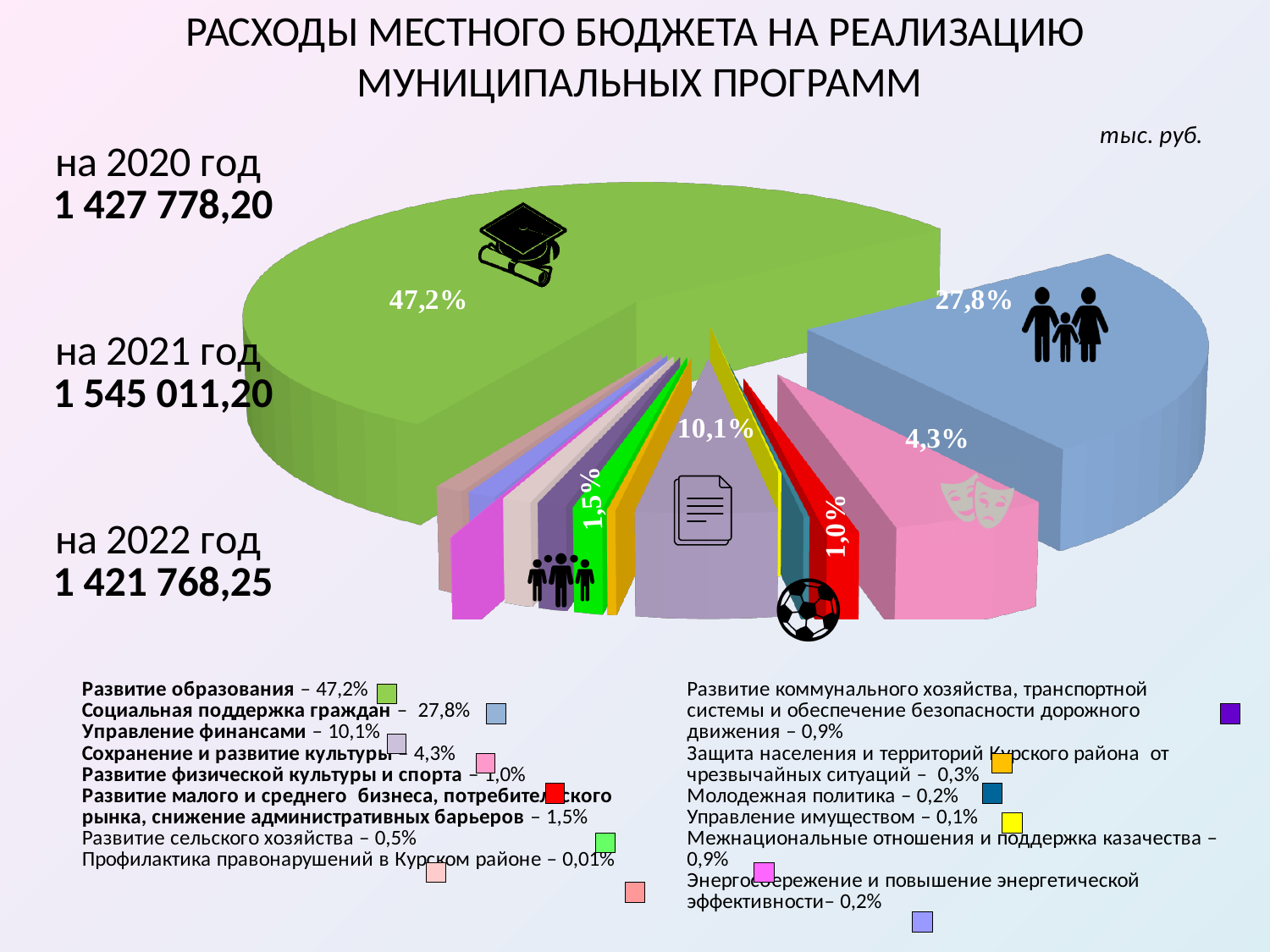
Which is larger: the share for "Управление финансами" or for "Сохранение и развитие культуры"? Управление финансами What percentage is given for "Сохранение и развитие культуры"? 4,3% What is the value for "Развитие физической культуры и спорта"? 1,0% How many categories does the legend list? 14 What is the value for "Управление финансами"? 10,1% What is the total local budget expenditure shown for 2021 (тыс. руб.)? 1 545 011,20 What kind of chart is shown on the slide? pie chart What share of the pie does "Развитие образования" take? 47,2% What is the difference between the shares of "Развитие образования" and "Социальная поддержка граждан"? 19,4% What percentage is shown for "Социальная поддержка граждан"? 27,8% Which category has the smallest share according to the legend? Профилактика правонарушений в Курском районе Which category has the largest share of the pie? Развитие образования